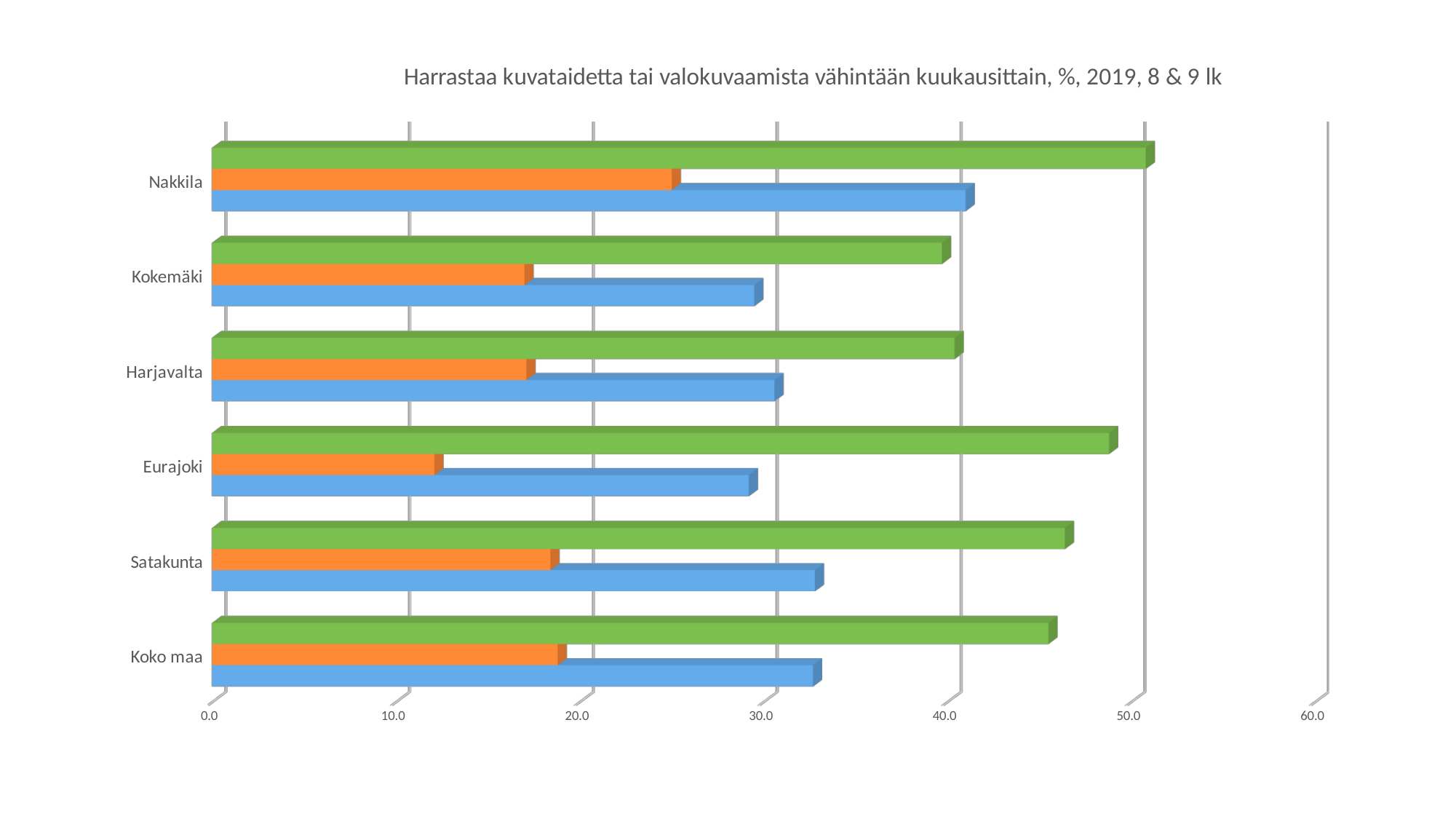
What is the title of the chart? Harrastaa kuvataidetta tai valokuvaamista vähintään kuukausittain, %, 2019, 8 & 9 lk Which has the longer green bar, Satakunta or Kokemäki? Satakunta Is the green bar for Nakkila greater or less than 40? greater Which category has the longest green bar? Nakkila Which has the longer orange bar, Nakkila or Kokemäki? Nakkila Which category has the longest blue bar? Nakkila What kind of chart is shown on the slide? bar chart Is the blue bar for Satakunta greater or less than 30? greater Which category has the shortest orange bar? Eurajoki Is the orange bar for Eurajoki greater or less than 20? less How many categories (areas) are shown on the vertical axis of the chart? 6